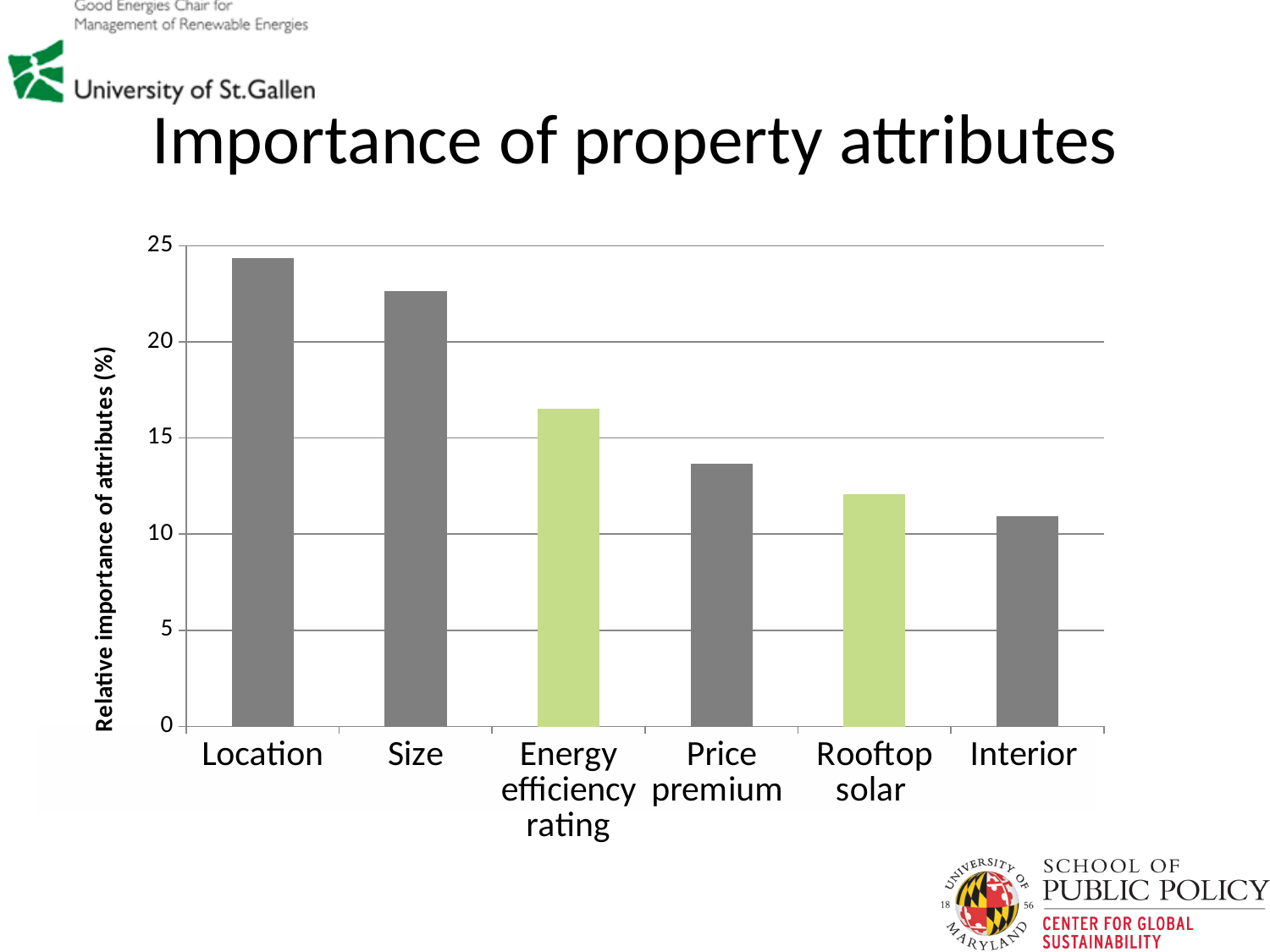
What is the label on the y axis of the chart? Relative importance of attributes (%) Is the value for Location greater or less than 20? greater What kind of chart is shown on the slide? Bar chart Which property attribute has the highest relative importance? Location Is the value for Price premium greater or less than 15? less Is the value for Interior greater or less than 15? less Do the values rise or fall moving from Location to Interior along the x axis? Fall Which property attribute has the lowest relative importance? Interior How many property attributes are shown on the x axis? 6 Which has a larger value, Size or Energy efficiency rating? Size